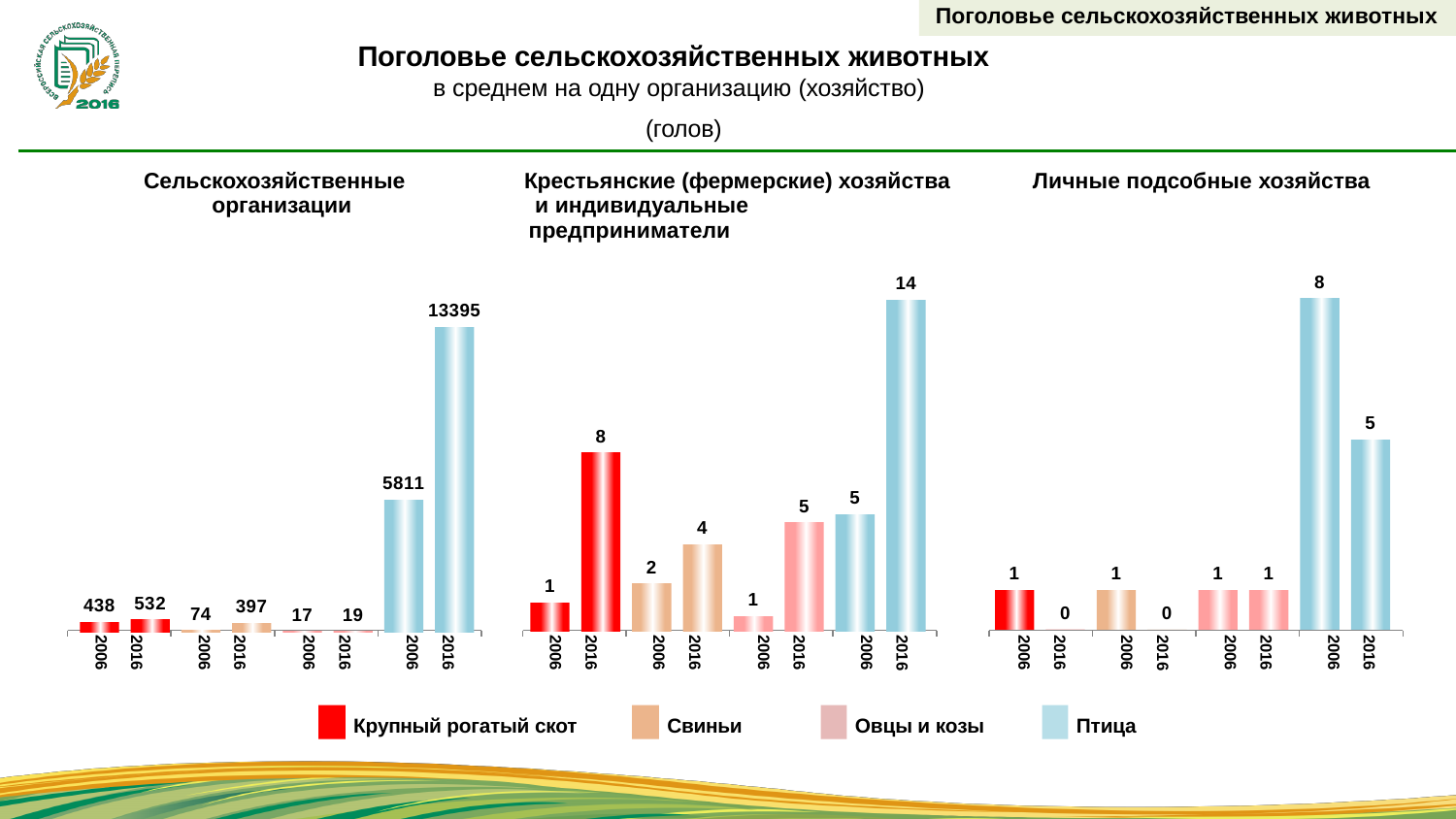
In the chart 'Сельскохозяйственные организации', what is the value for Птица in 2016? 13395 In the chart 'Сельскохозяйственные организации', what is the value for Свиньи in 2006? 74 In the chart 'Личные подсобные хозяйства', what is the value for Свиньи in 2016? 0 In the chart 'Сельскохозяйственные организации', which series has the lowest value in 2006? Овцы и козы In the chart 'Личные подсобные хозяйства', what is the value for Птица in 2006? 8 In the chart 'Крестьянские (фермерские) хозяйства и индивидуальные предприниматели', which series has the highest value in 2016? Птица How many series does the legend list? 4 In the chart 'Крестьянские (фермерские) хозяйства и индивидуальные предприниматели', is the 2016 value for Крупный рогатый скот larger or smaller than the 2016 value for Свиньи? larger What kind of chart is used on this slide? bar chart In the chart 'Крестьянские (фермерские) хозяйства и индивидуальные предприниматели', what is the value for Птица in 2016? 14 In the chart 'Личные подсобные хозяйства', does the value for Птица rise or fall from 2006 to 2016? fall In the chart 'Сельскохозяйственные организации', what is the difference between the Птица values for 2016 and 2006? 7584